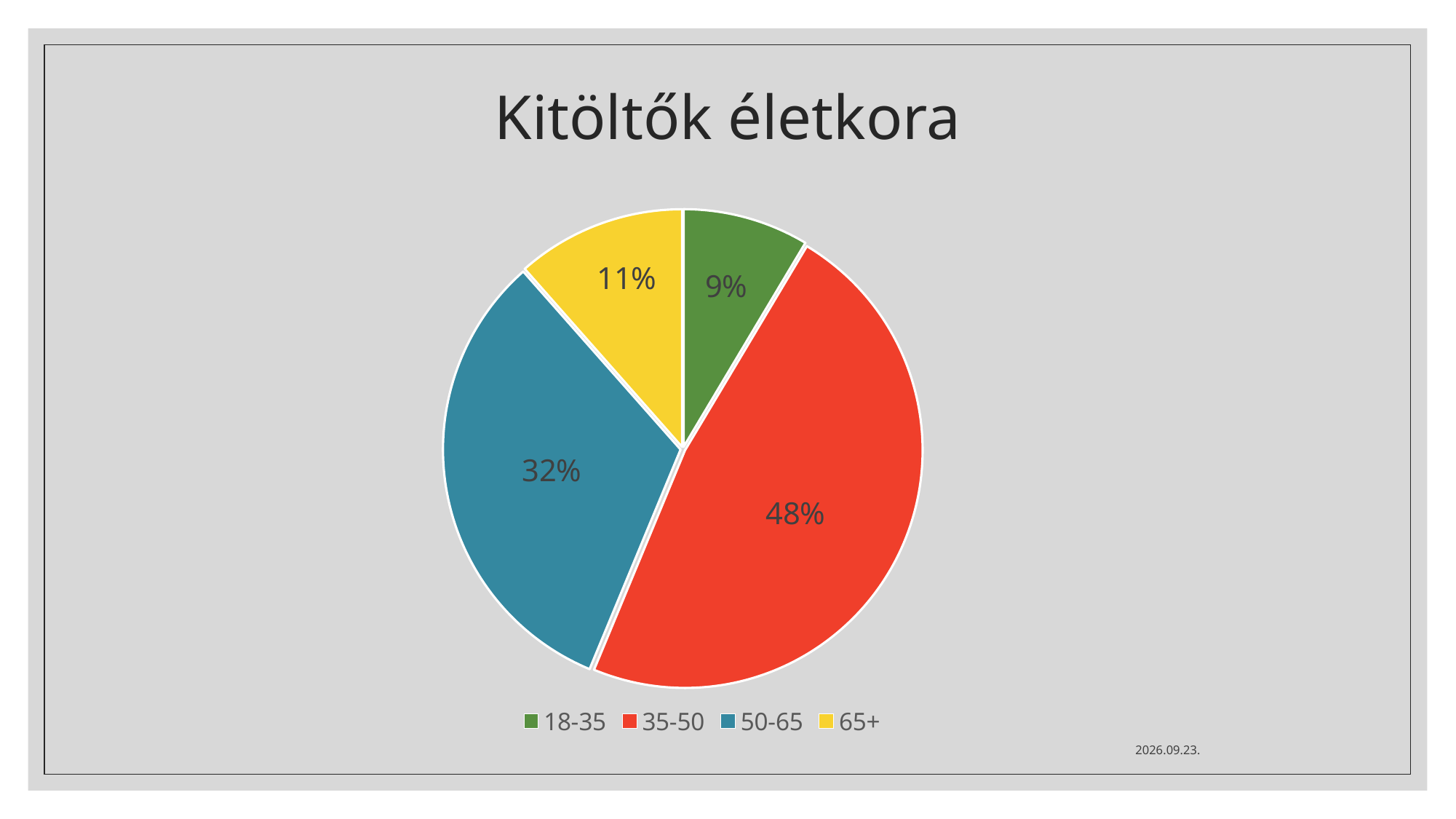
What is the value shown for the 18-35 slice? 9% Which age group has the smallest share of the pie? 18-35 What share of the pie does the 35-50 age group have? 48% What share of the pie does the 50-65 age group have? 32% What is the difference in percentage points between the 65+ and 18-35 slices? 2 How many age groups are shown in the pie chart? 4 What is the value shown for the 65+ slice? 11% Which slice is larger, 65+ or 18-35? 65+ What is the difference in percentage points between the 35-50 and 50-65 slices? 16 What kind of chart is shown on the slide? Pie chart Which age group has the largest share of the pie? 35-50 What is the title of the chart? Kitöltők életkora